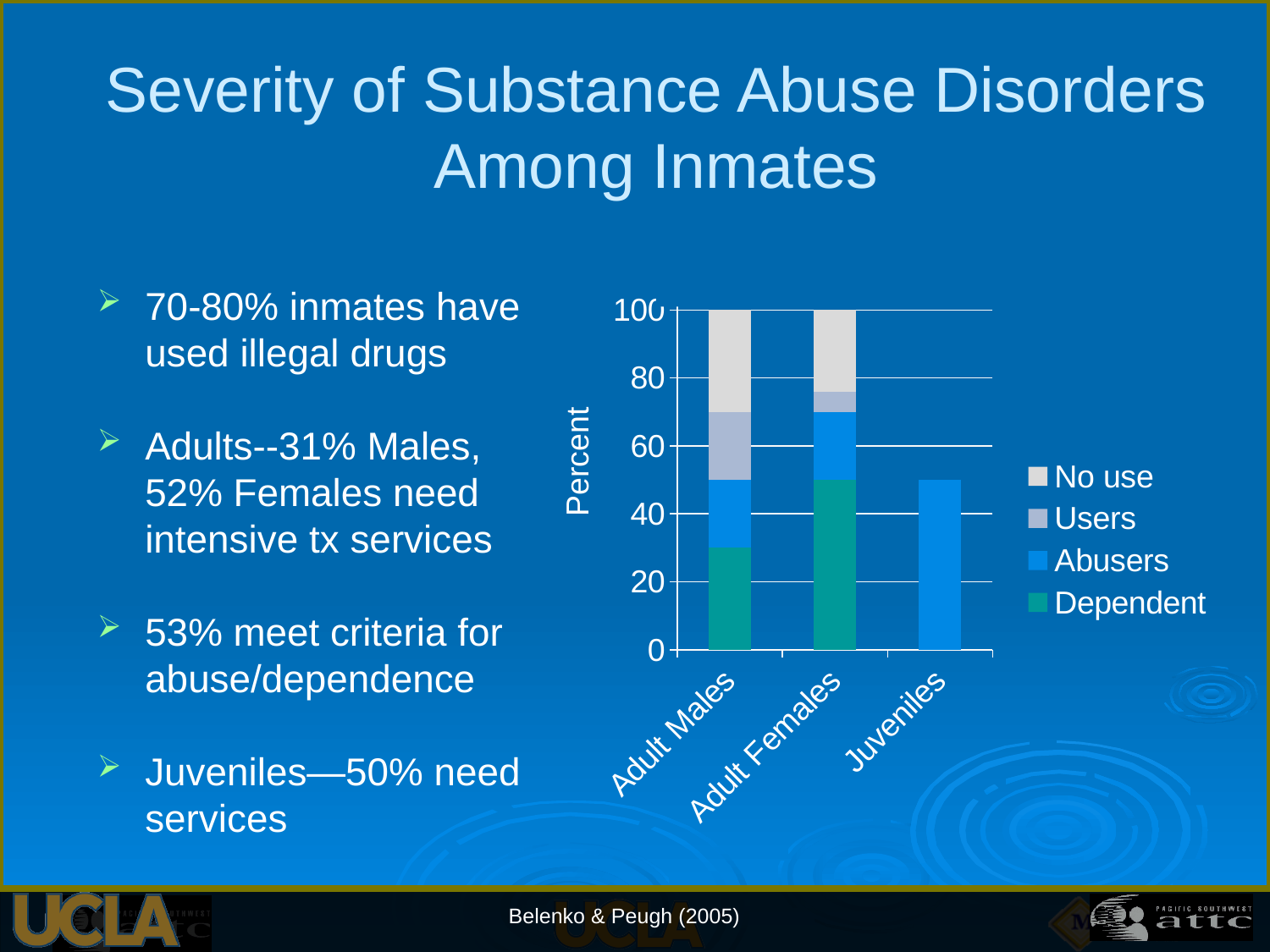
What are the series listed in the chart's legend? No use, Users, Abusers, Dependent What kind of chart is shown on the slide? bar chart Which category has the largest Dependent segment? Adult Females Is the Dependent value for Adult Females greater or less than 40? greater Is the Dependent segment larger for Adult Males or Adult Females? Adult Females Is the Users segment larger for Adult Males or Adult Females? Adult Males What is the label on the chart's vertical axis? Percent How many categories are shown on the x axis of the chart? 3 Which category has the shortest stacked bar overall? Juveniles Is the total height of the Juveniles bar greater or less than 40? greater How many series does the chart's legend list? 4 Is the Dependent value for Adult Males greater or less than 40? less